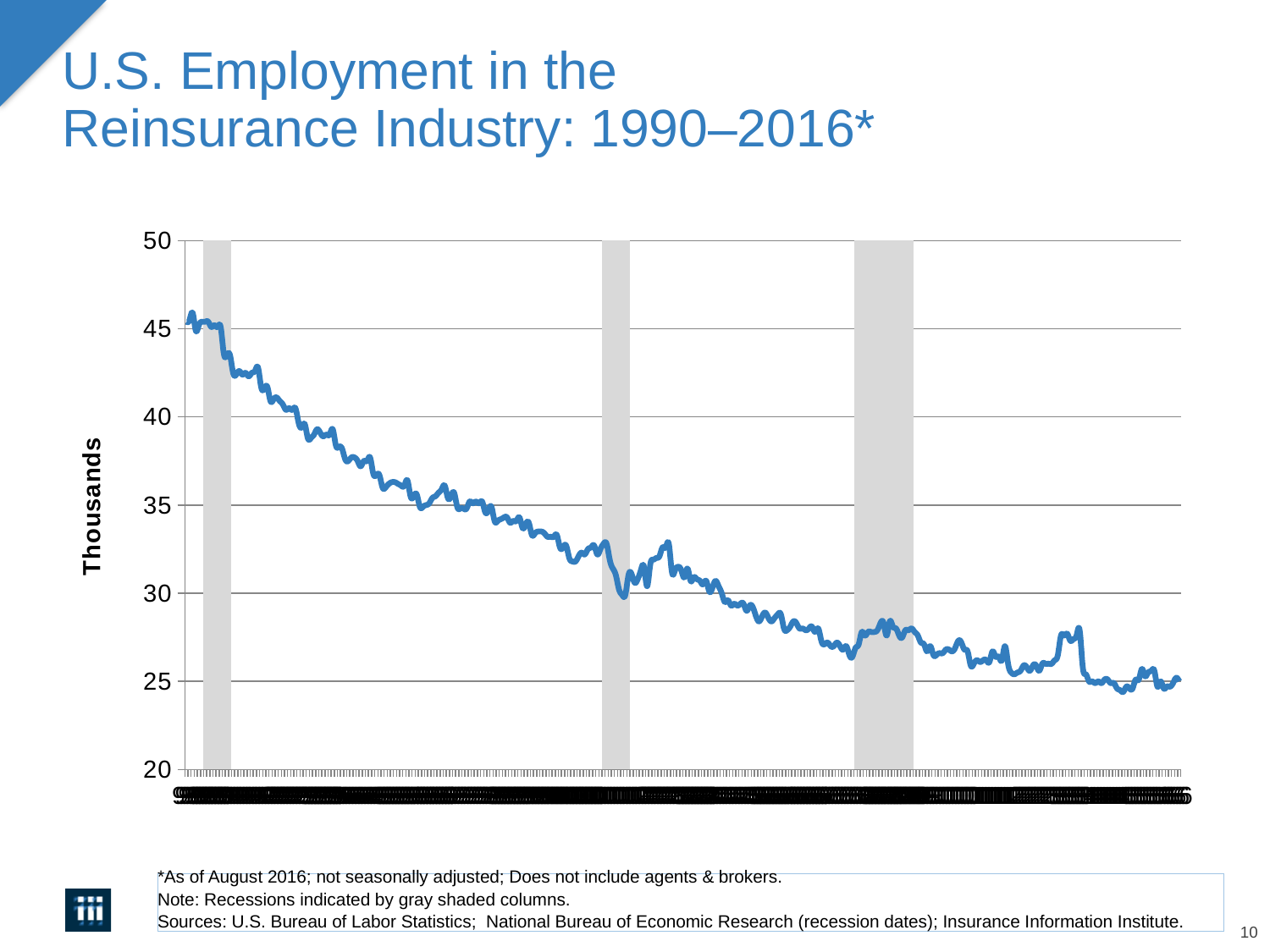
Is the value at the end of the line (2016) greater or less than 20? greater Does the line ever reach a value greater than 50? no Is the value at the start of the line (1990) greater or less than 40? greater How many gray shaded columns (recessions) are shown on the chart? 3 What kind of chart is shown on the slide? line chart What is the title of the y axis? Thousands Which is larger, the value at the start of the line (1990) or the value at the end of the line (2016)? the value at the start (1990) Do the values in the chart generally rise or fall from left to right along the x axis? fall